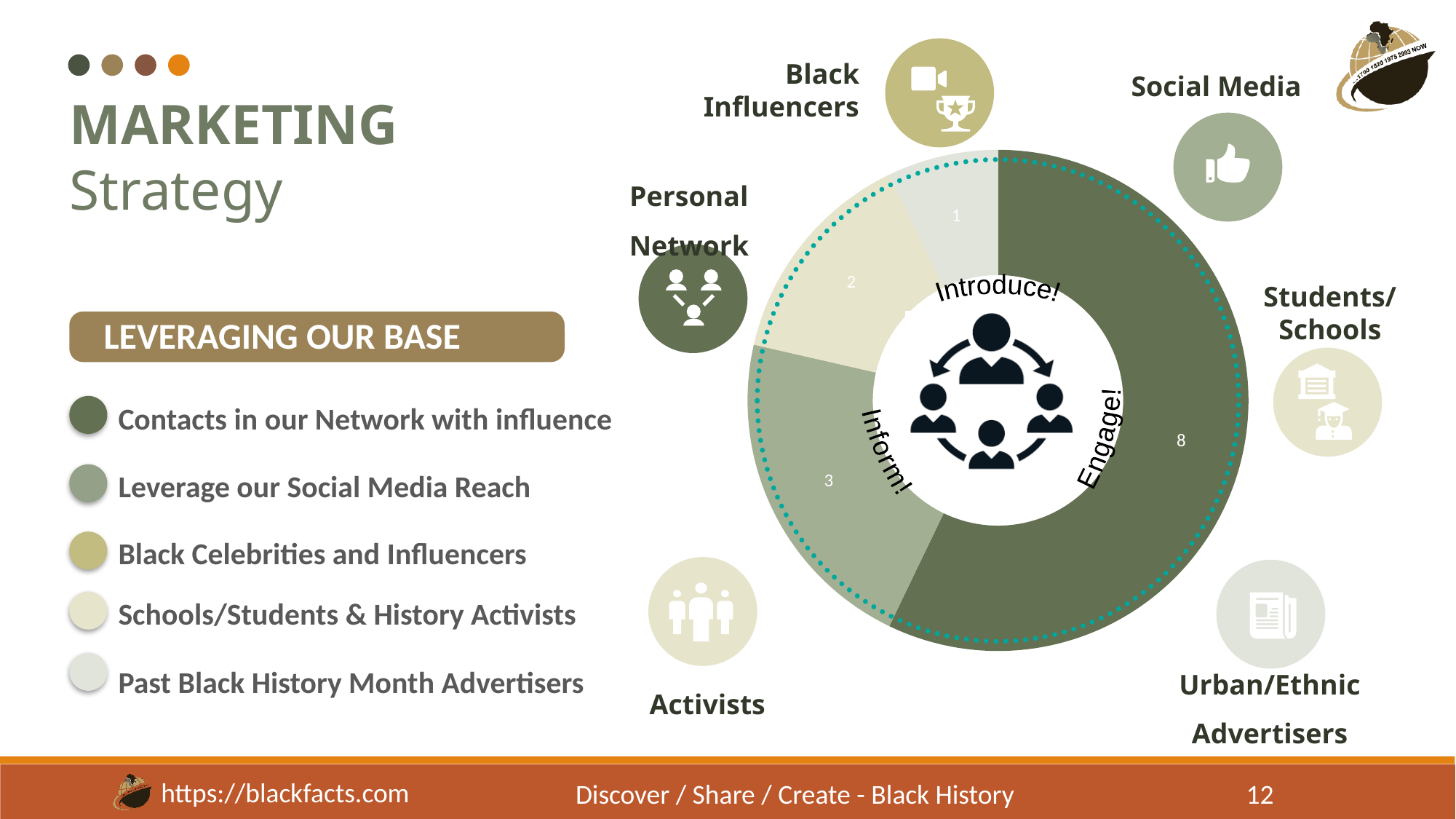
Which is larger: the sage green segment or the light beige segment? The sage green segment How many items does the legend on the left list? 5 What is the smallest value labelled on the doughnut chart? 1 What value is shown on the light grey segment (Past Black History Month Advertisers)? 1 What kind of chart is shown on the slide? Doughnut (pie) chart What value is shown on the dark green segment (Contacts in our Network with influence)? 8 What value is shown on the largest segment of the doughnut chart? 8 What value is shown on the sage green segment (Leverage our Social Media Reach)? 3 Which legend entry is represented by the dark green colour? Contacts in our Network with influence What is the difference between the segment labelled 8 and the segment labelled 3? 5 What three words are written around the centre of the doughnut chart? Introduce!, Engage!, Inform! What value is shown on the light beige segment (Schools/Students & History Activists)? 2